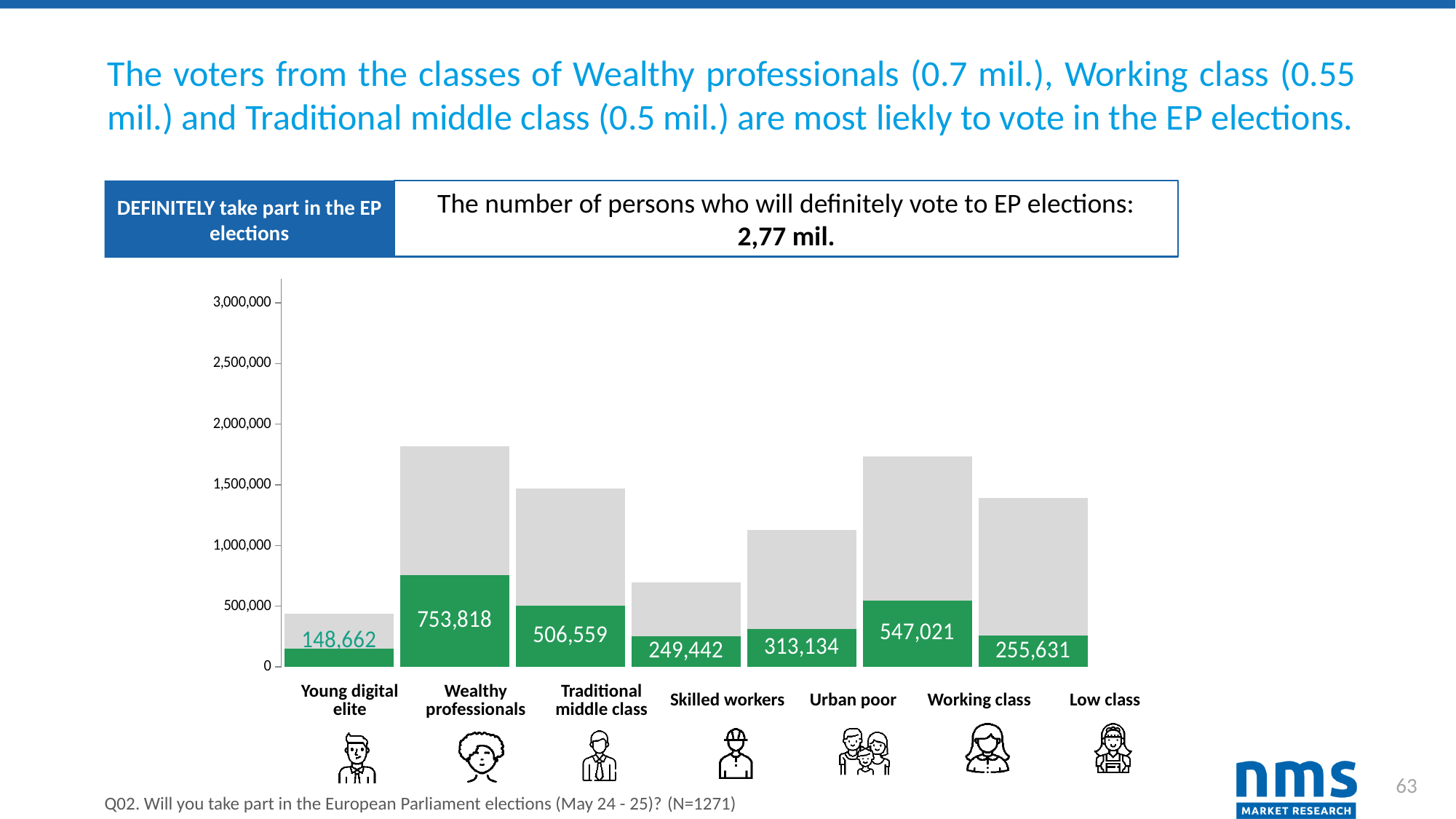
How many classes are shown on the x axis of the chart? 7 Which class has the lowest number of persons who will definitely vote? Young digital elite Is the grey bar for Skilled workers greater or less than 1,000,000? less Which is larger, the value for Urban poor or the value for Low class? Urban poor Which class has the highest number of persons who will definitely vote? Wealthy professionals What is the difference between the values for Traditional middle class and Skilled workers? 257,117 What is the number of persons in the Wealthy professionals class who will definitely vote in the EP elections? 753,818 What kind of chart is shown on the slide? Bar chart What is the value shown for Low class? 255,631 What is the difference between the values for Wealthy professionals and Working class? 206,797 Is the grey bar for Wealthy professionals greater or less than 1,500,000? greater What is the value shown for Urban poor? 313,134